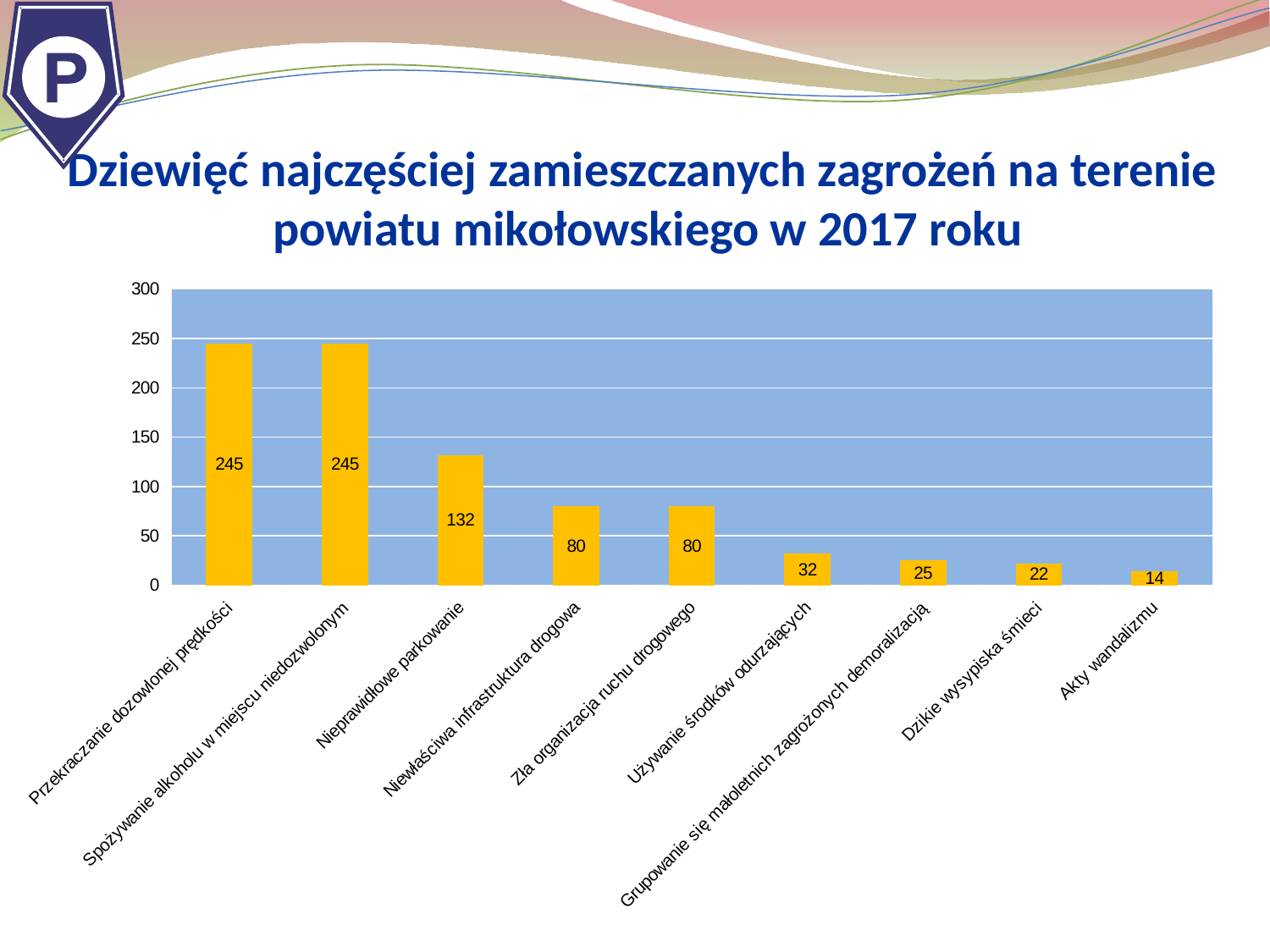
What value is shown for Dzikie wysypiska śmieci? 22 What value is shown for Nieprawidłowe parkowanie? 132 How many categories are shown on the chart? 9 What value is shown for Akty wandalizmu? 14 Do the values rise or fall from left to right along the x axis? fall Which is larger, the value for Używanie środków odurzających or the value for Grupowanie się małoletnich zagrożonych demoralizacją? Używanie środków odurzających Is the value for Niewłaściwa infrastruktura drogowa greater or less than 100? less What is the difference between the values for Nieprawidłowe parkowanie and Zła organizacja ruchu drogowego? 52 Which category has the lowest value? Akty wandalizmu What kind of chart is shown on the slide? bar chart What is the difference between the values for Przekraczanie dozwolonej prędkości and Akty wandalizmu? 231 What value is shown for Używanie środków odurzających? 32